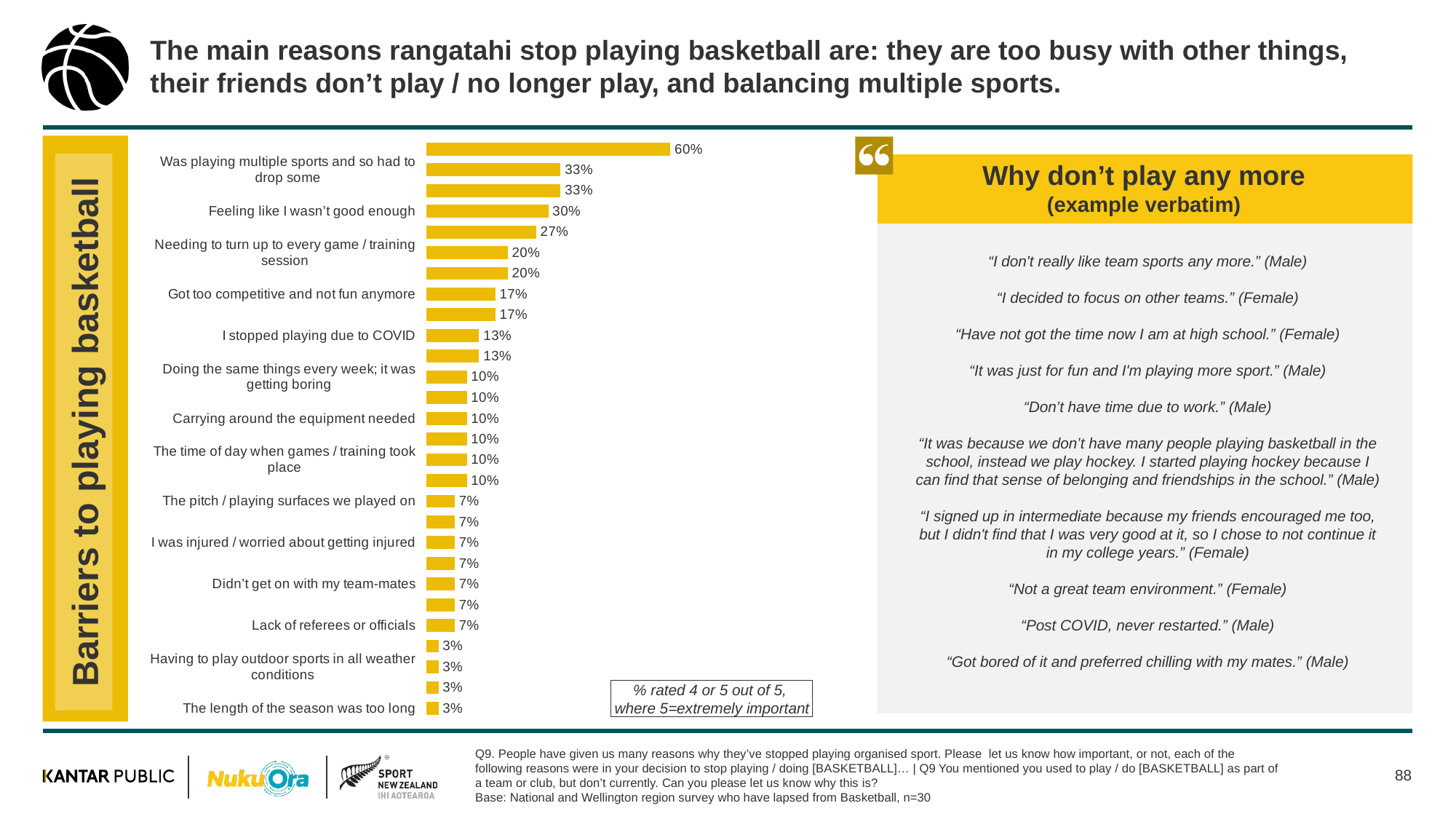
What type of chart is used to show the barriers to playing basketball? Bar chart What is the difference between "Was playing multiple sports and so had to drop some" (33%) and "Feeling like I wasn't good enough" (30%)? 3 percentage points What is the highest value shown on the chart? 60% What percentage is shown for "Was playing multiple sports and so had to drop some"? 33% Which has a higher value: "Needing to turn up to every game / training session" or "Lack of referees or officials"? Needing to turn up to every game / training session What percentage is shown for "The length of the season was too long"? 3% What percentage is shown for "Feeling like I wasn't good enough"? 30% What is the lowest value shown on the chart? 3% What percentage is shown for "I stopped playing due to COVID"? 13% What percentage is shown for "Got too competitive and not fun anymore"? 17% How many bars are plotted on the chart? 28 What is the vertical title on the left side of the chart? Barriers to playing basketball